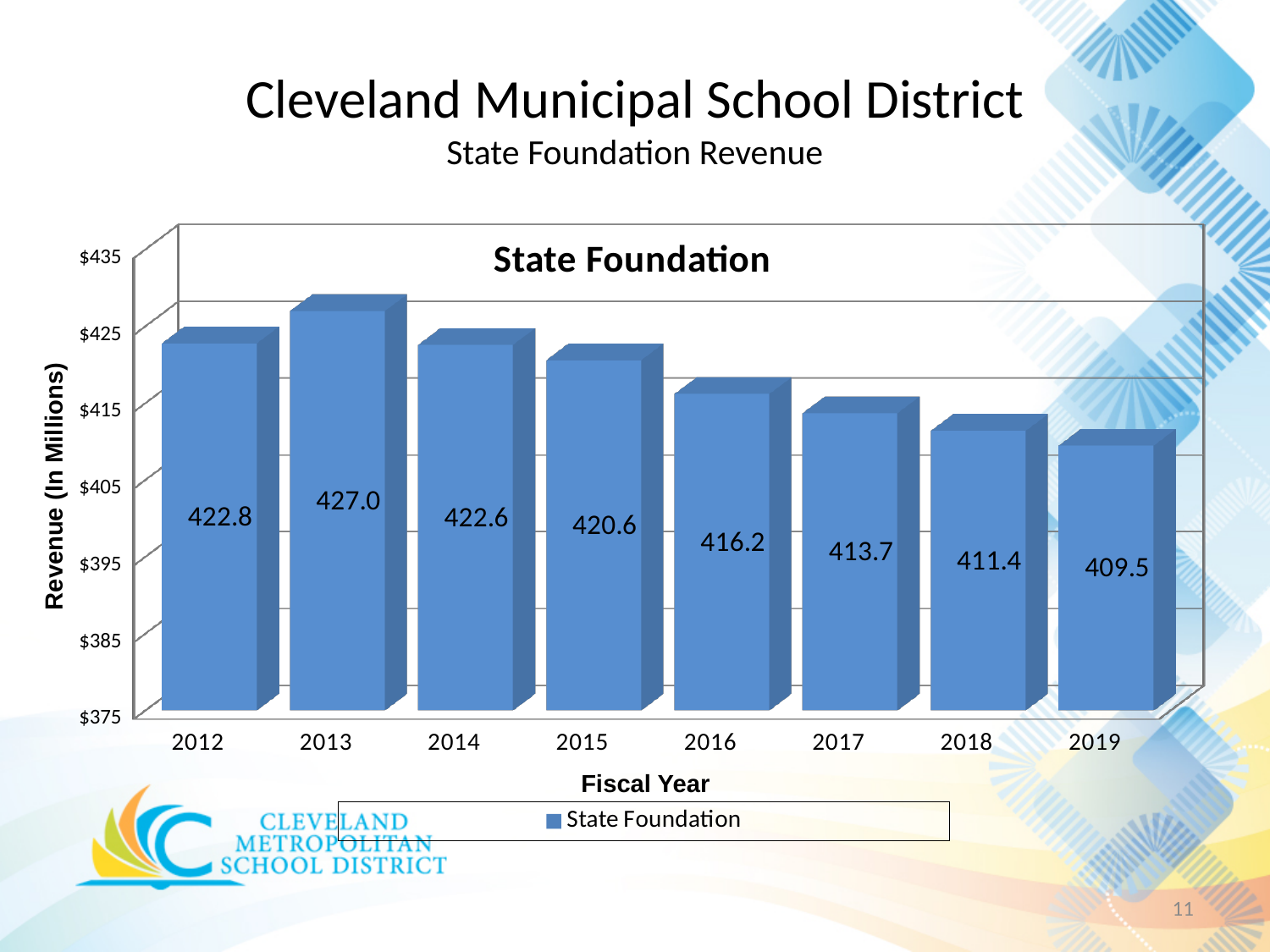
Which fiscal year has the larger State Foundation revenue, 2015 or 2017? 2015 From 2013 to 2019, does the State Foundation revenue rise or fall? fall What is the State Foundation revenue for fiscal year 2016? 416.2 What is the difference between the State Foundation revenue in 2012 and in 2014? 0.2 What is the difference between the State Foundation revenue in 2013 and in 2019? 17.5 How many fiscal years are shown on the chart? 8 What is the State Foundation revenue for fiscal year 2013? 427.0 What is the State Foundation revenue for fiscal year 2019? 409.5 Is the State Foundation revenue for 2018 greater or less than $415? less What kind of chart is shown on the slide? bar chart Which fiscal year has the lowest State Foundation revenue? 2019 Which fiscal year has the highest State Foundation revenue? 2013